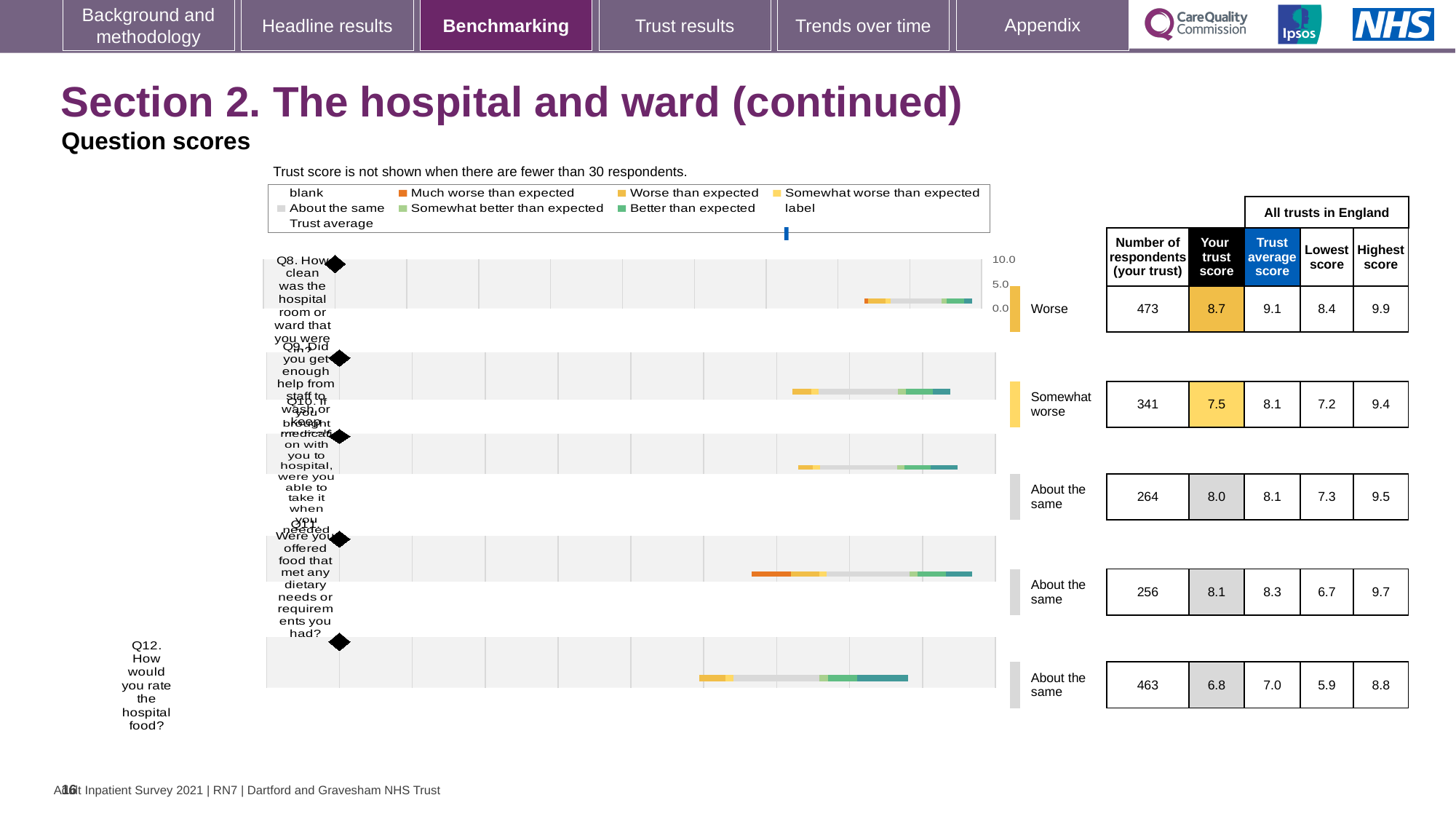
Which question had the most respondents at this trust? Q8 How many questions are plotted on the chart? 5 Which question has the highest trust score? Q8 Which has the larger trust score, Q9 or Q10? Q10 What is the trust score for Q8 (How clean was the hospital room or ward that you were in?)? 8.7 What is the difference between the trust average score and this trust's score for Q12? 0.2 What is the lowest score across all trusts in England for Q12? 5.9 How many respondents answered Q12 (How would you rate the hospital food?) at this trust? 463 What is the highest score across all trusts in England for Q11? 9.7 What benchmark category is shown for Q9 (Did you get enough help from staff to wash or keep yourself clean?)? Somewhat worse Which question has the lowest trust score? Q12 What kind of chart is used to show the question scores? Bar chart